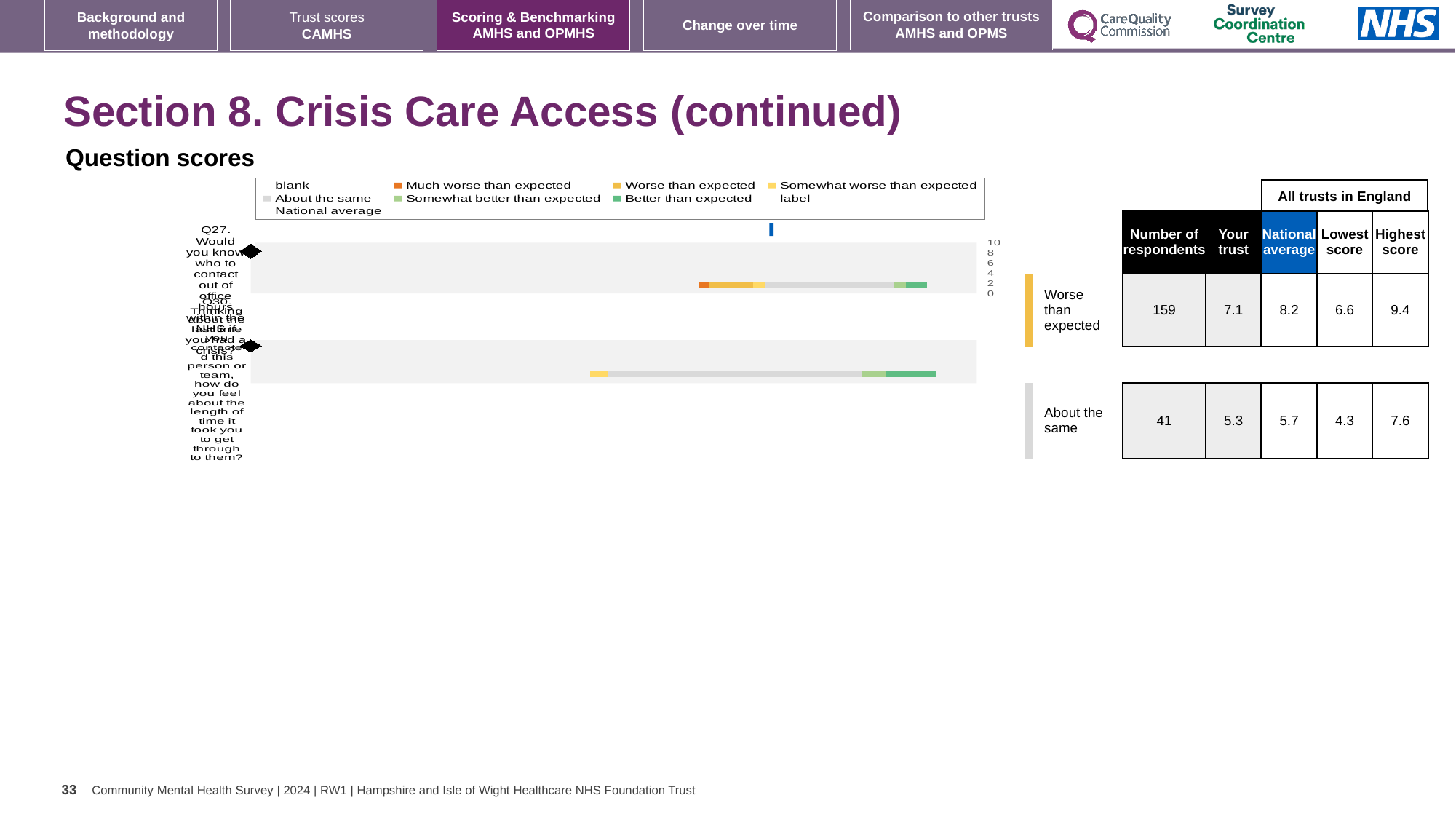
What is the 'Your trust' score for the second question (Q30) in the table beside the chart? 5.3 According to the table beside the chart, how many respondents answered the first question (Q27)? 159 What colour does the legend use for 'Much worse than expected'? orange What colour does the legend use for 'Better than expected'? green What is the difference between the highest score (9.4) and the lowest score (6.6) for the first question (Q27)? 2.8 How many entries does the chart legend list? 9 What is the highest score among all trusts in England for the second question (Q30)? 7.6 For the first question (Q27), which is larger: the 'Your trust' score or the national average? National average How many survey questions (bars) are plotted in the chart? 2 What is the 'Your trust' score for the first question (Q27) in the table beside the chart? 7.1 What kind of chart is shown under 'Question scores'? bar chart What is the national average for the first question (Q27) in the table beside the chart? 8.2